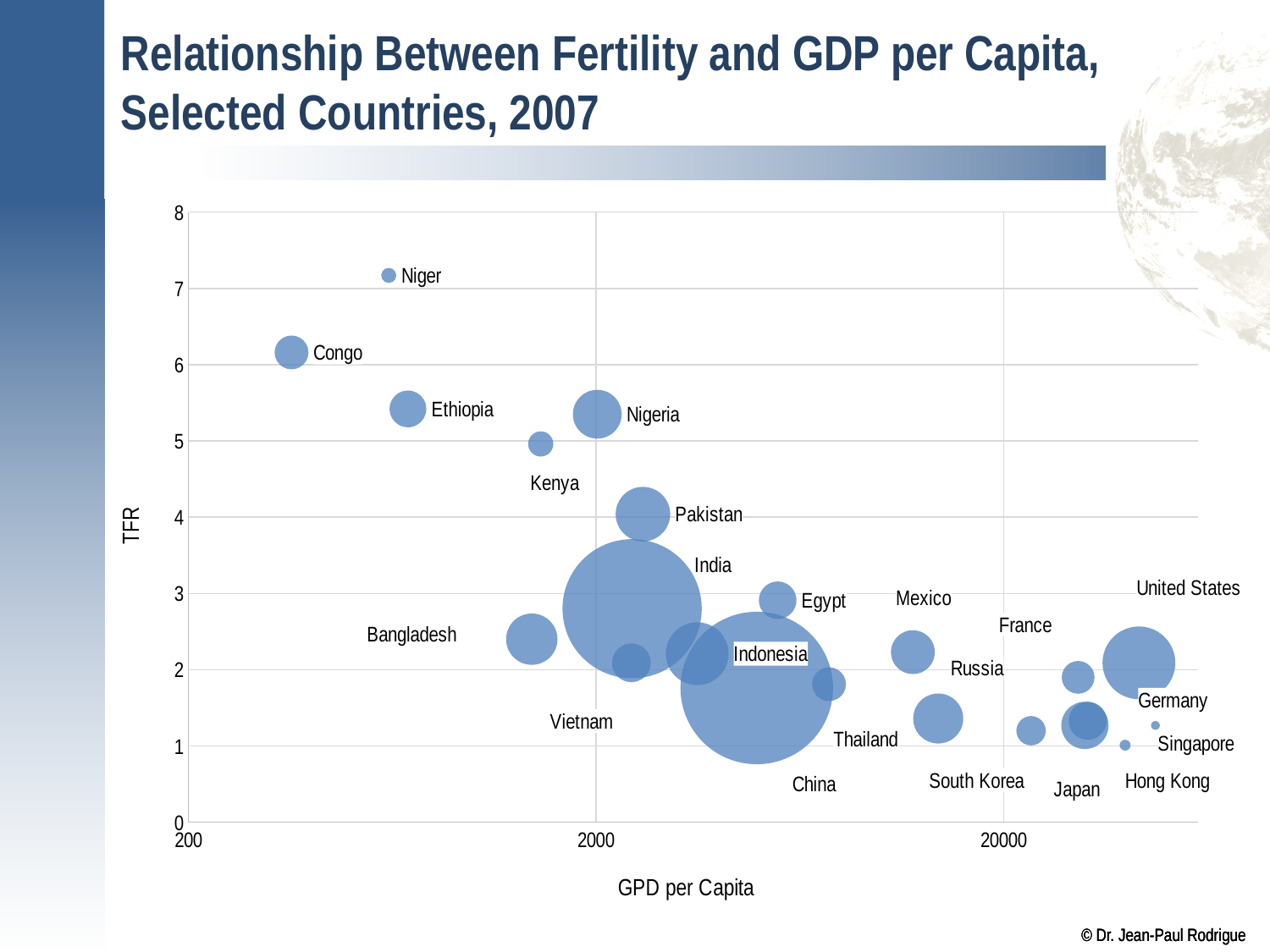
Is the TFR for Bangladesh greater or less than 2? greater What kind of chart is shown on the slide? bubble chart Is the TFR for Nigeria greater or less than 5? greater As GDP per capita increases along the x axis, does TFR generally rise or fall? fall Which country has the lowest TFR on the chart? Hong Kong Is the TFR for Thailand greater or less than 2? less Which country has the highest TFR on the chart? Niger What is the label on the y axis of the chart? TFR Which country is represented by the largest bubble? China Which has the higher TFR, Niger or Congo? Niger Which has the higher TFR, Congo or Ethiopia? Congo